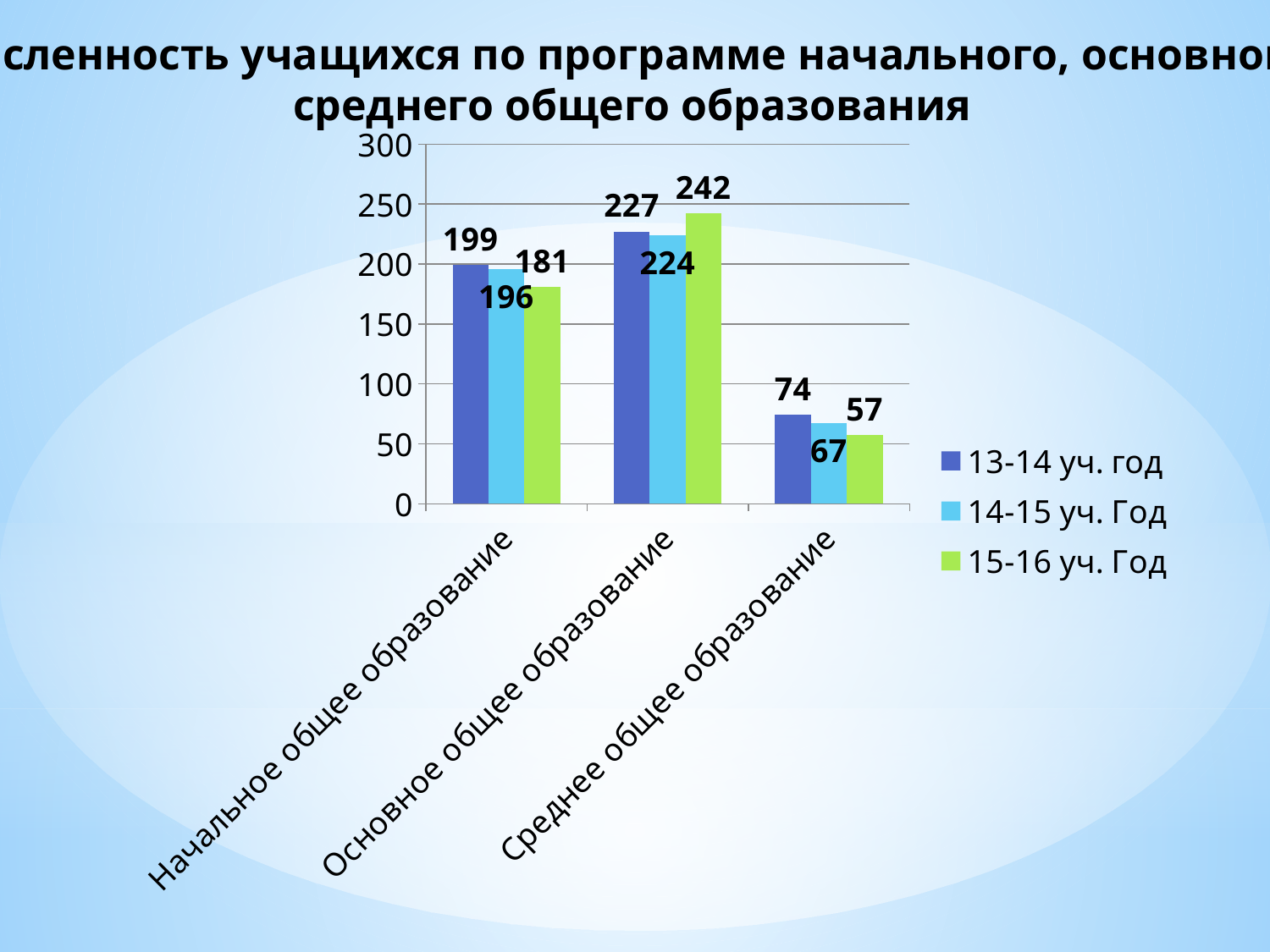
Which category has the lowest value in the 13-14 уч. год series? Среднее общее образование Is the value for Основное общее образование in the 14-15 уч. Год series greater or less than 200? greater What kind of chart is shown on the slide? bar chart Do the values for Среднее общее образование rise or fall from 13-14 уч. год to 15-16 уч. Год? fall What is the value for Основное общее образование in the 15-16 уч. Год series? 242 What is the value for Среднее общее образование in the 14-15 уч. Год series? 67 Which is larger for Начальное общее образование: the 13-14 уч. год value or the 15-16 уч. Год value? 13-14 уч. год What is the value for Начальное общее образование in the 13-14 уч. год series? 199 Which category has the highest value in the 15-16 уч. Год series? Основное общее образование What is the difference between the 13-14 уч. год and 15-16 уч. Год values for Среднее общее образование? 17 How many categories are shown on the x axis? 3 How many series does the legend list? 3